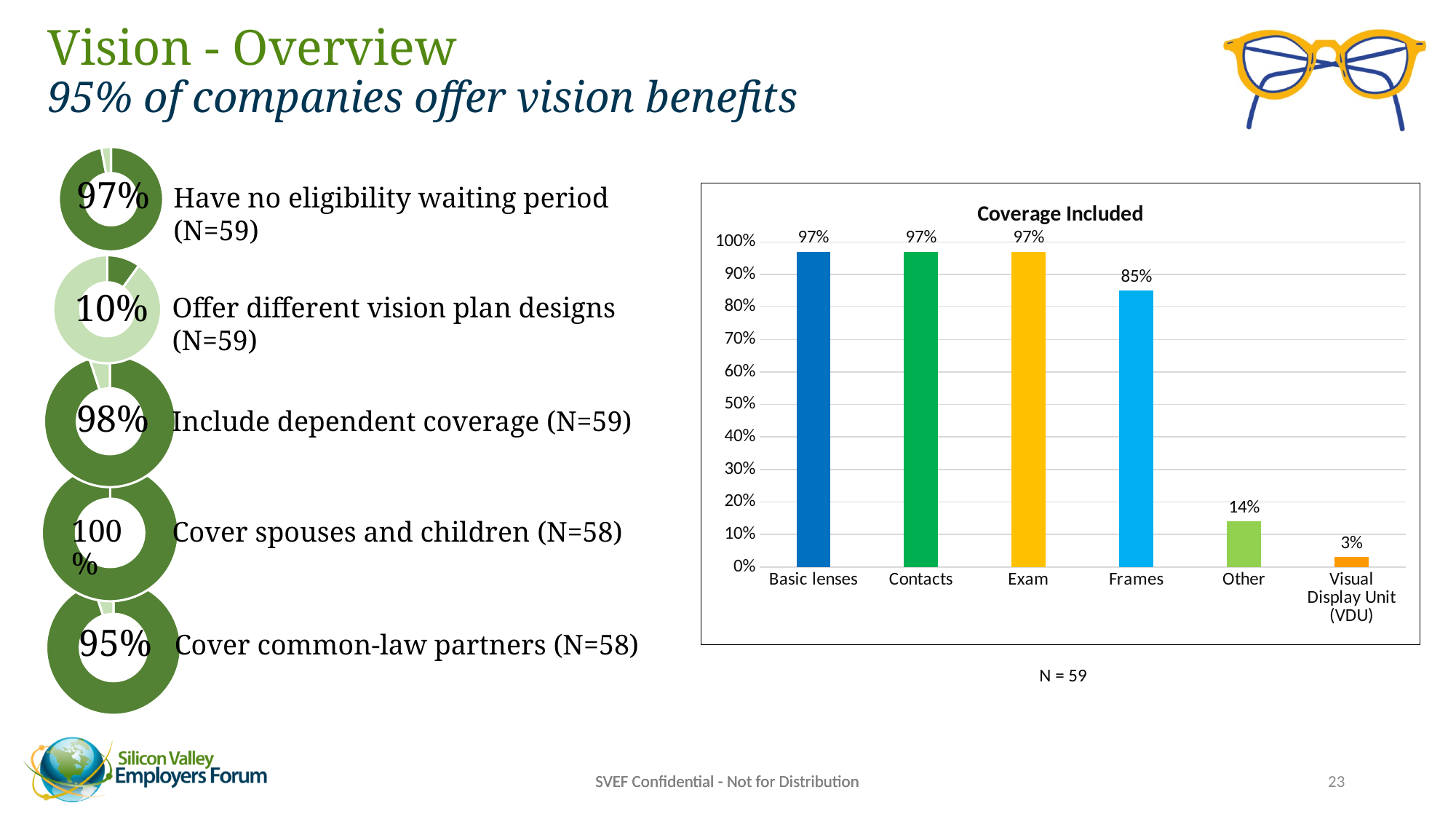
What type of chart is the "Coverage Included" chart? Bar chart In the "Coverage Included" bar chart, what percentage is shown for Other? 14% In the "Coverage Included" bar chart, how many categories are plotted? 6 In the "Coverage Included" bar chart, what is the difference between the values for Exam and Frames? 12% In the donut charts on the left of the slide, what percentage of companies offer different vision plan designs? 10% In the "Coverage Included" bar chart, which category has the lowest value? Visual Display Unit (VDU) In the donut charts on the left of the slide, what percentage of companies cover common-law partners? 95% In the "Coverage Included" bar chart, what sample size (N) is noted below the chart? N = 59 In the "Coverage Included" bar chart, what percentage is shown for Frames? 85% In the "Coverage Included" bar chart, what percentage is shown for Contacts? 97% In the "Coverage Included" bar chart, what percentage is shown for Visual Display Unit (VDU)? 3% In the "Coverage Included" bar chart, which is larger, the value for Frames or the value for Other? Frames